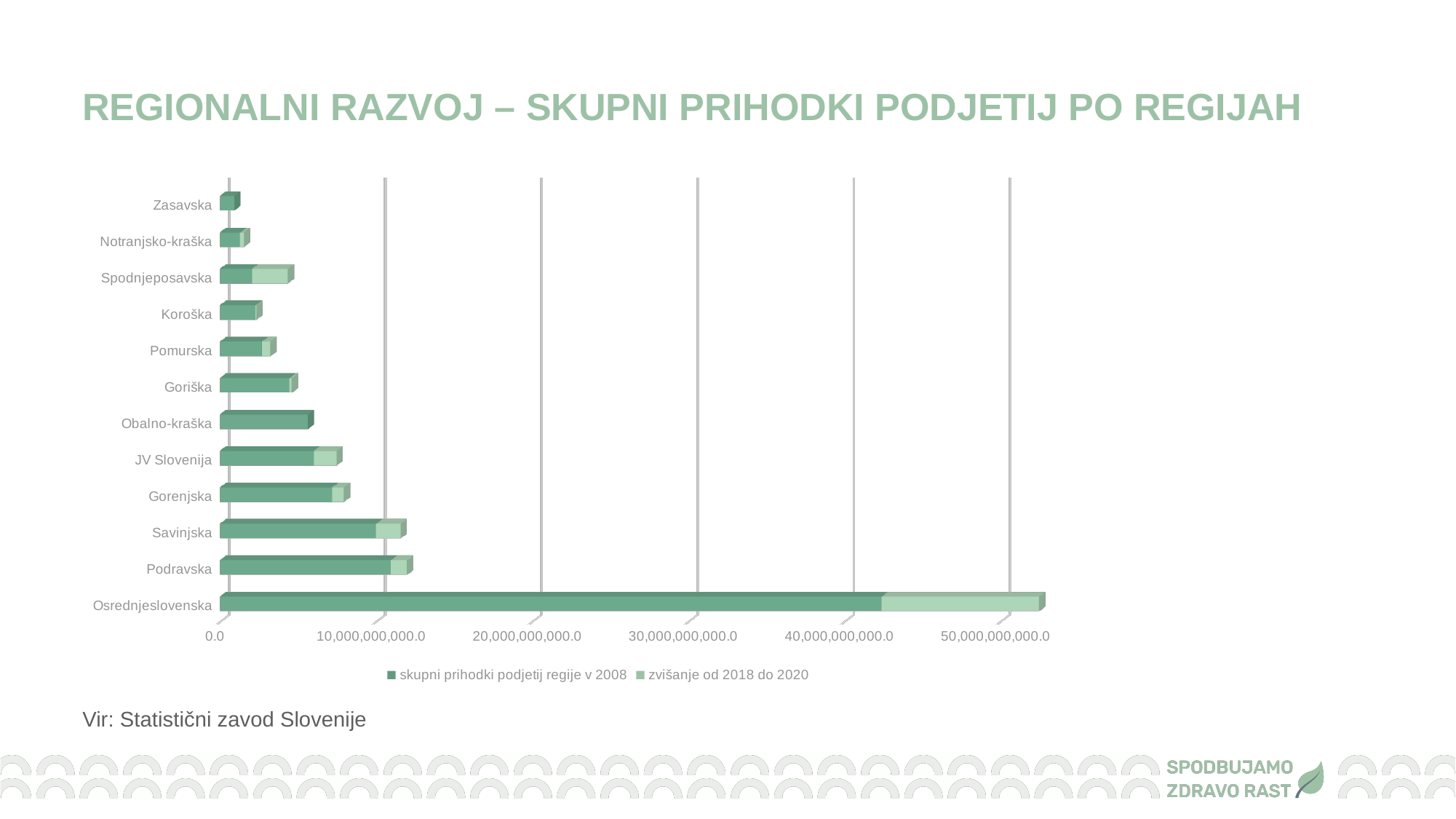
How many regions are listed on the vertical axis of the chart? 12 What are the two series named in the chart legend? skupni prihodki podjetij regije v 2008; zvišanje od 2018 do 2020 What kind of chart is shown on the slide? Bar chart How many series does the chart legend list? 2 Which region has the longer total bar, Spodnjeposavska or Koroška? Spodnjeposavska Is the total bar length for Podravska greater or less than 20,000,000,000.0? less Is the total bar length for Osrednjeslovenska greater or less than 50,000,000,000.0? greater Is the total bar length for Gorenjska greater or less than 10,000,000,000.0? less Which region has the larger 'skupni prihodki podjetij regije v 2008' value, Obalno-kraška or Goriška? Obalno-kraška Which region has the shortest bar in the chart? Zasavska Which region has the longest bar in the chart? Osrednjeslovenska